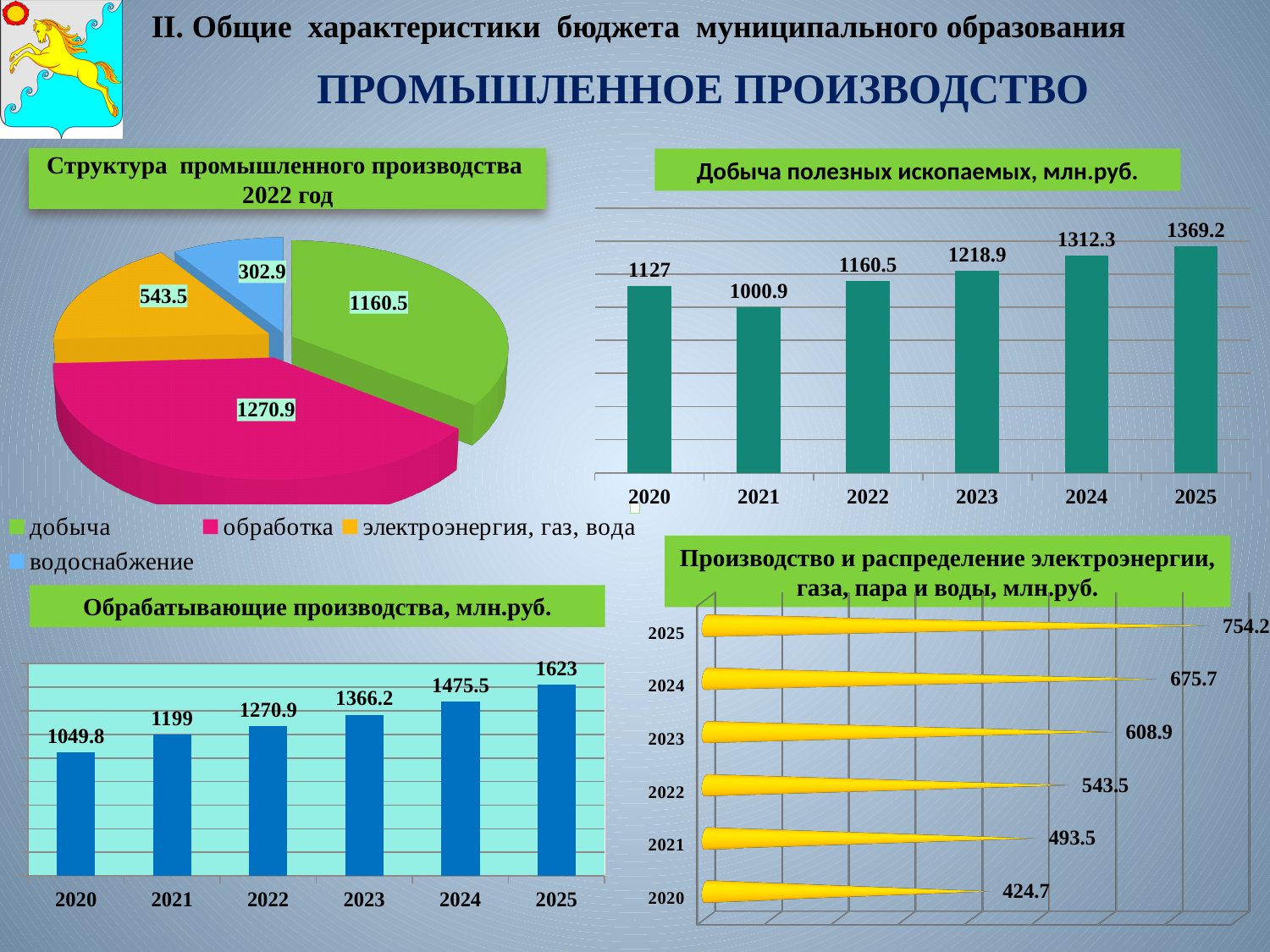
Which is larger: the 2022 value in 'Добыча полезных ископаемых, млн.руб.' or the 2022 value in 'Обрабатывающие производства, млн.руб.'? Обрабатывающие производства (1270.9) In the chart 'Обрабатывающие производства, млн.руб.', do the values rise or fall from 2020 to 2025? rise In the chart 'Производство и распределение электроэнергии, газа, пара и воды, млн.руб.', what is the value for 2021? 493.5 In the chart 'Добыча полезных ископаемых, млн.руб.', what is the value for 2023? 1218.9 In the chart 'Обрабатывающие производства, млн.руб.', what is the value for 2024? 1475.5 In the chart 'Производство и распределение электроэнергии, газа, пара и воды, млн.руб.', what is the difference between the 2025 and 2024 values? 78.5 In the pie chart 'Структура промышленного производства 2022 год', how many categories does the legend list? 4 In the chart 'Добыча полезных ископаемых, млн.руб.', which year has the lowest value? 2021 In the chart 'Добыча полезных ископаемых, млн.руб.', what is the difference between the 2025 and 2020 values? 242.2 In the pie chart 'Структура промышленного производства 2022 год', what is the value for обработка? 1270.9 In the pie chart 'Структура промышленного производства 2022 год', which category has the smallest slice? водоснабжение In the chart 'Обрабатывающие производства, млн.руб.', how many years are plotted? 6